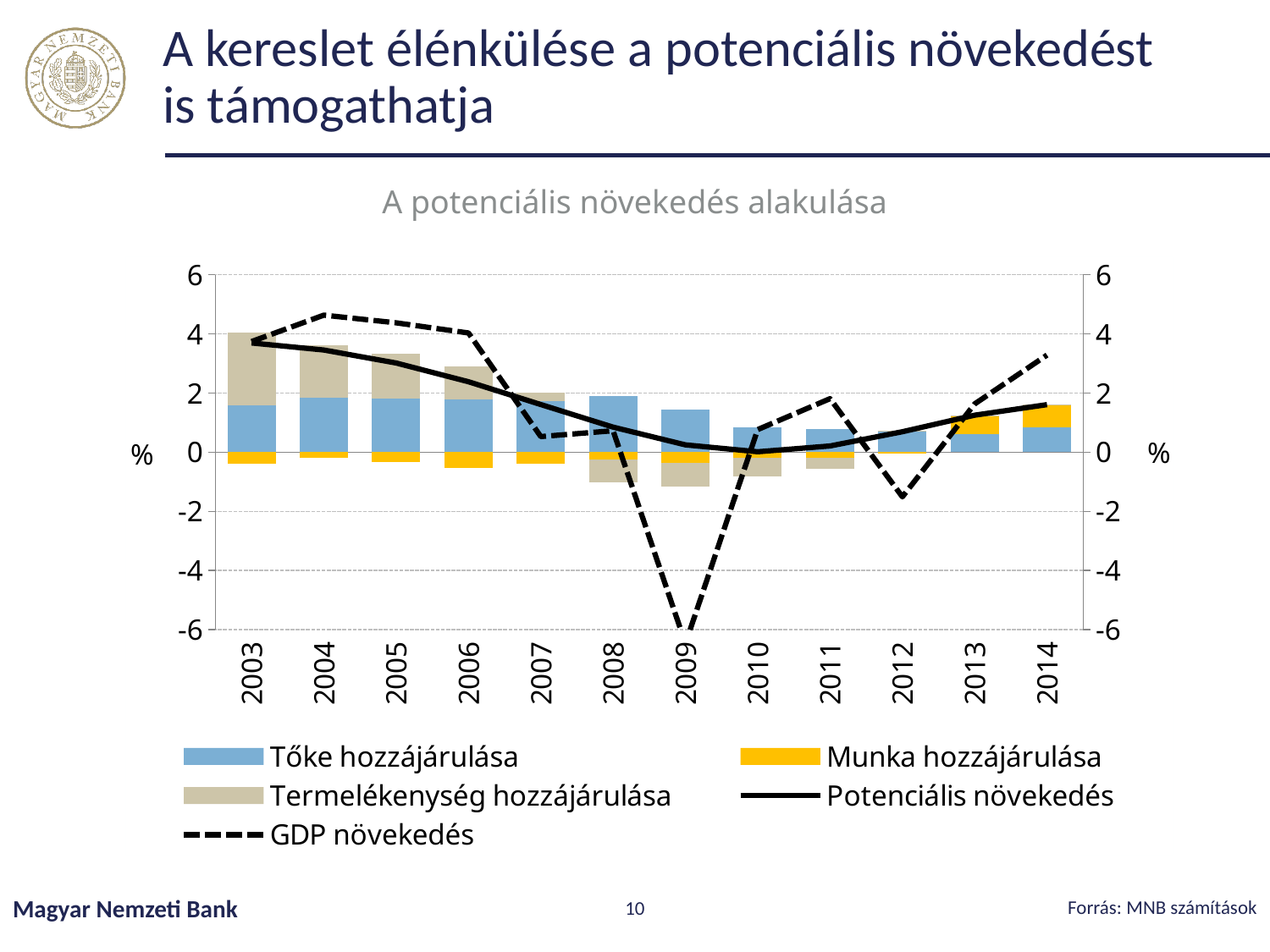
How many years are shown on the x axis of the chart? 12 In which year is the GDP növekedés line at its highest? 2004 How many series does the chart's legend list? 5 Is the GDP növekedés value for 2012 greater or less than 0? less In which year is the Potenciális növekedés line at its highest? 2003 Which series is drawn as a dashed line in the chart? GDP növekedés Does the Potenciális növekedés line rise or fall between 2003 and 2010? fall Is the Potenciális növekedés value for 2003 greater or less than 2? greater What is the title of the chart? A potenciális növekedés alakulása In which year is the GDP növekedés line at its lowest? 2009 What kind of chart is shown on the slide? A combined stacked bar and line chart Is the GDP növekedés value for 2009 greater or less than -4? less